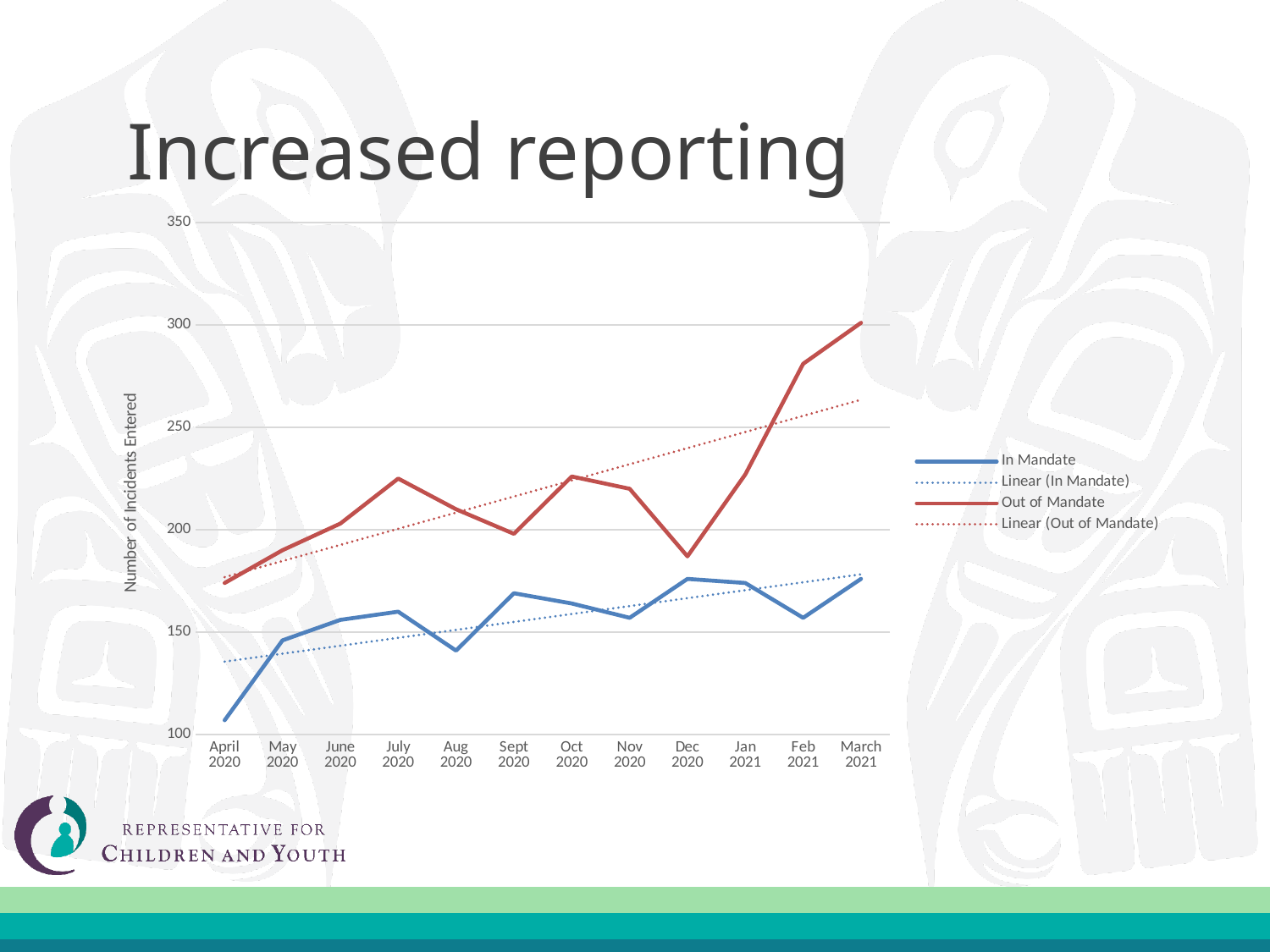
Is the Out of Mandate value for Feb 2021 greater or less than 250? greater In March 2021, which series has the larger value, In Mandate or Out of Mandate? Out of Mandate What is the label on the vertical axis? Number of Incidents Entered What is the title of the chart? Increased reporting In which month is the Out of Mandate series at its lowest? April 2020 What kind of chart is shown on the slide? Line chart In which month is the Out of Mandate series at its highest? March 2021 How many entries does the legend list? 4 Is the In Mandate value for Aug 2020 greater or less than 150? less How many months are plotted along the x axis? 12 Is the Out of Mandate value for Dec 2020 greater or less than 200? less In which month is the In Mandate series at its lowest? April 2020